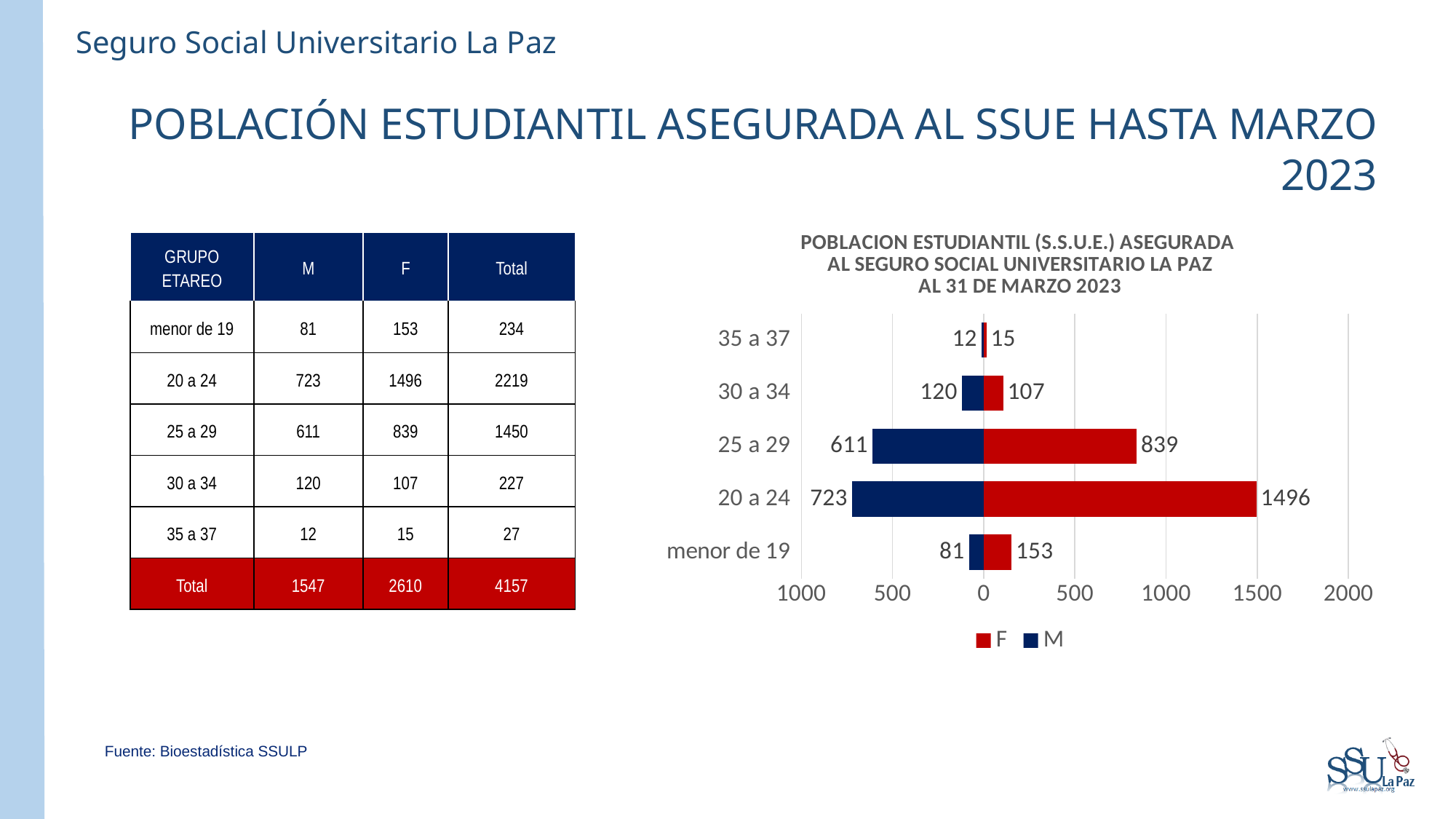
What kind of chart is shown on the slide? Bar chart Which colour represents the F series in the chart? Red Which age group has the highest F value in the chart? 20 a 24 How many series does the chart legend list? 2 For the 30 a 34 age group, which is larger, the M value or the F value? M What is the difference between the F and M values for the 20 a 24 age group? 773 Which age group has the lowest M value in the chart? 35 a 37 What is the F value for the 20 a 24 age group in the chart? 1496 How many age groups are shown in the chart? 5 What is the F value for the menor de 19 age group in the chart? 153 What is the combined total of M and F for the 25 a 29 age group in the chart? 1450 What is the M value for the 25 a 29 age group in the chart? 611